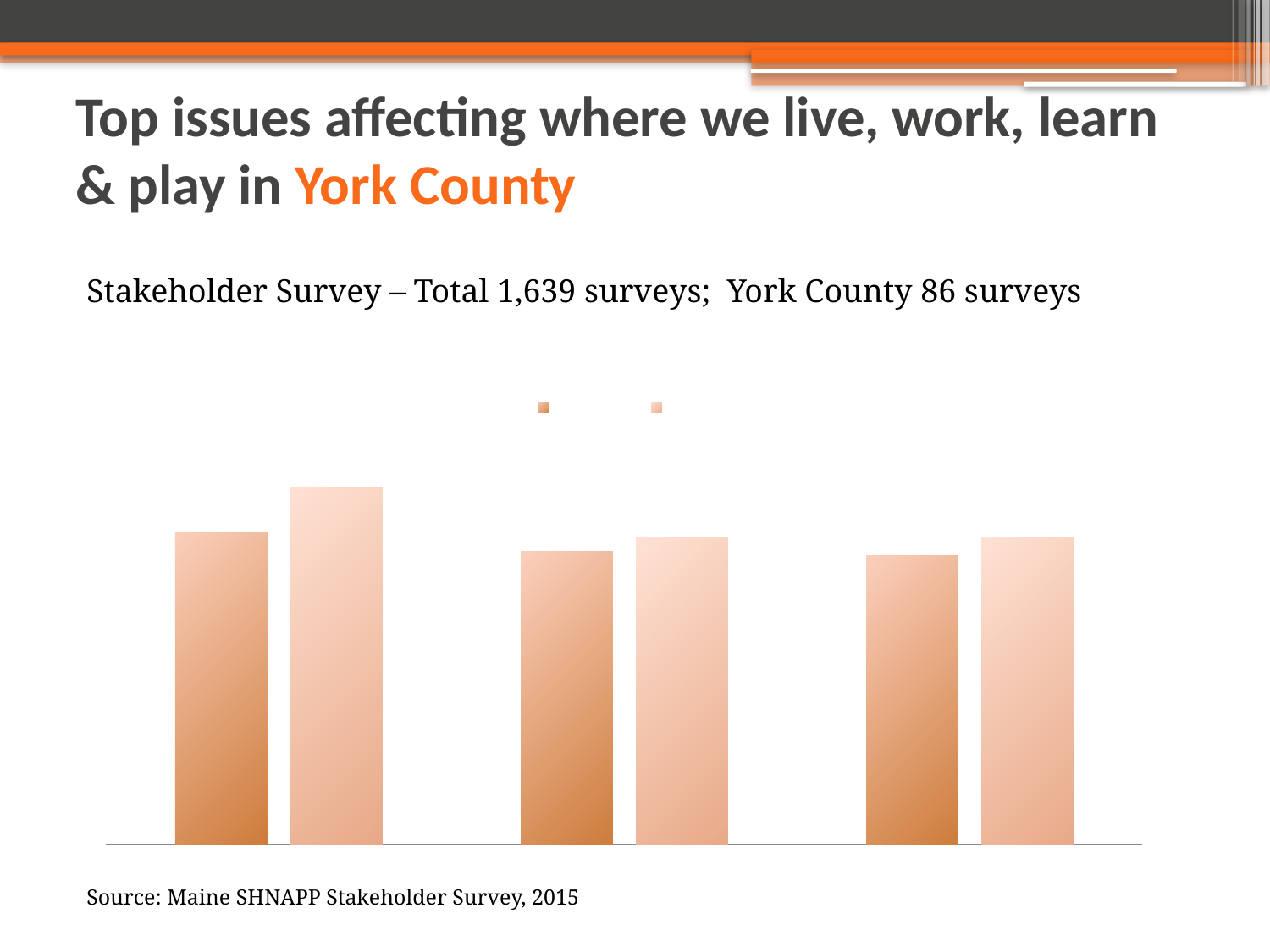
In the leftmost group of bars, is the darker orange bar or the lighter orange bar taller? the lighter orange bar What kind of chart is shown on the slide? bar chart How many bars are plotted in total on the chart? 6 Are the bars on the chart vertical or horizontal? vertical Which group of bars contains the tallest bar on the chart: the left, middle, or right group? the left group How many series does the chart's legend list? 2 How many groups of bars does the chart show? 3